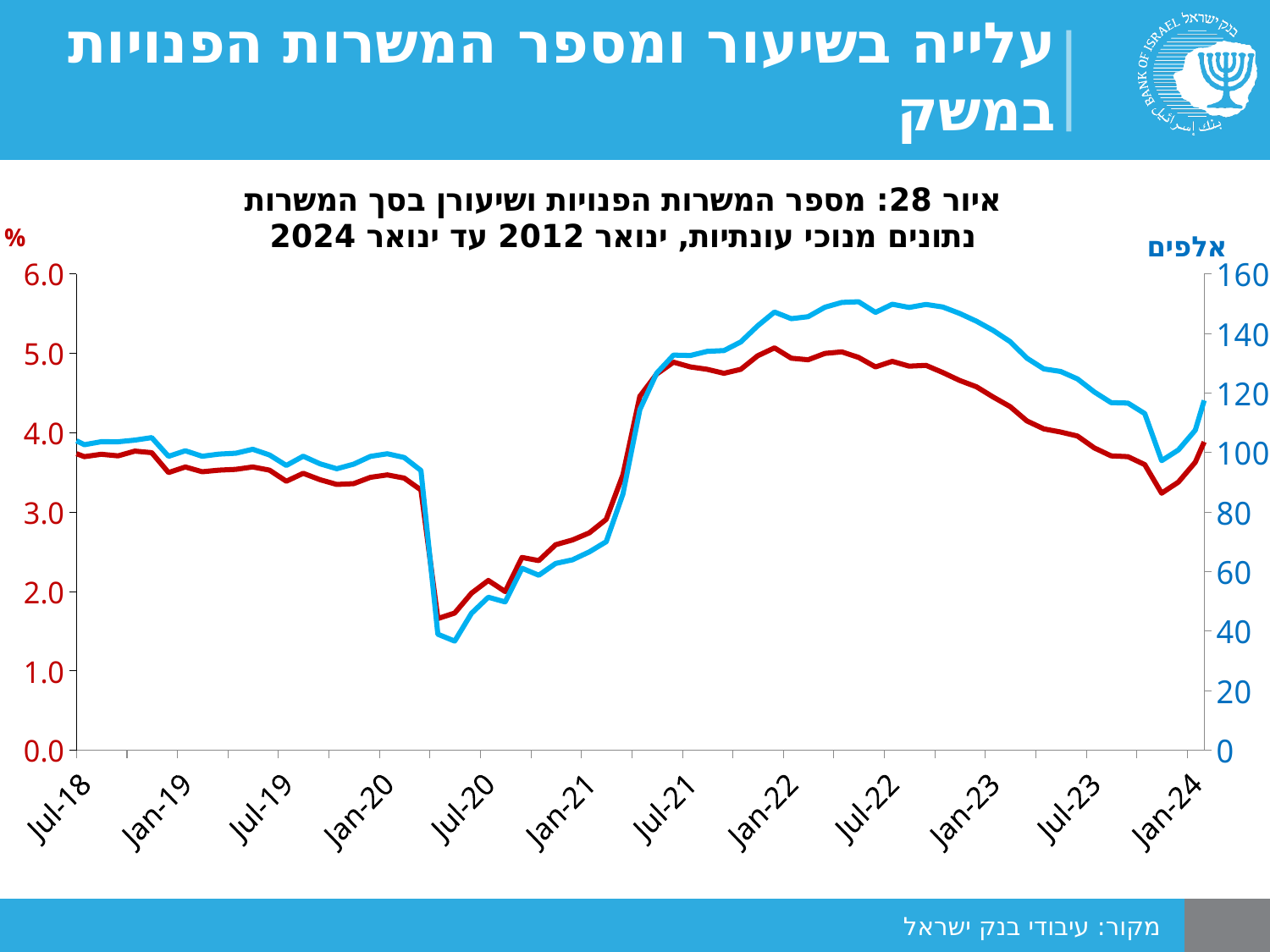
Is the value of the blue line at Jan-22 greater or less than 140? greater Is the value of the blue line at Jul-20 greater or less than 60? less Do the lines rise or fall between Jan-20 and Jul-20? fall Is the value of the red line at Jul-18 greater or less than 3.0? greater What unit label is shown above the right-hand axis? אלפים How many date labels are shown along the x axis? 12 Does the blue line rise or fall between Jul-20 and Jan-22? rise How many lines are plotted on the chart? 2 What kind of chart is shown on the slide? line chart Is the blue line higher at Jan-22 or at Jul-20? Jan-22